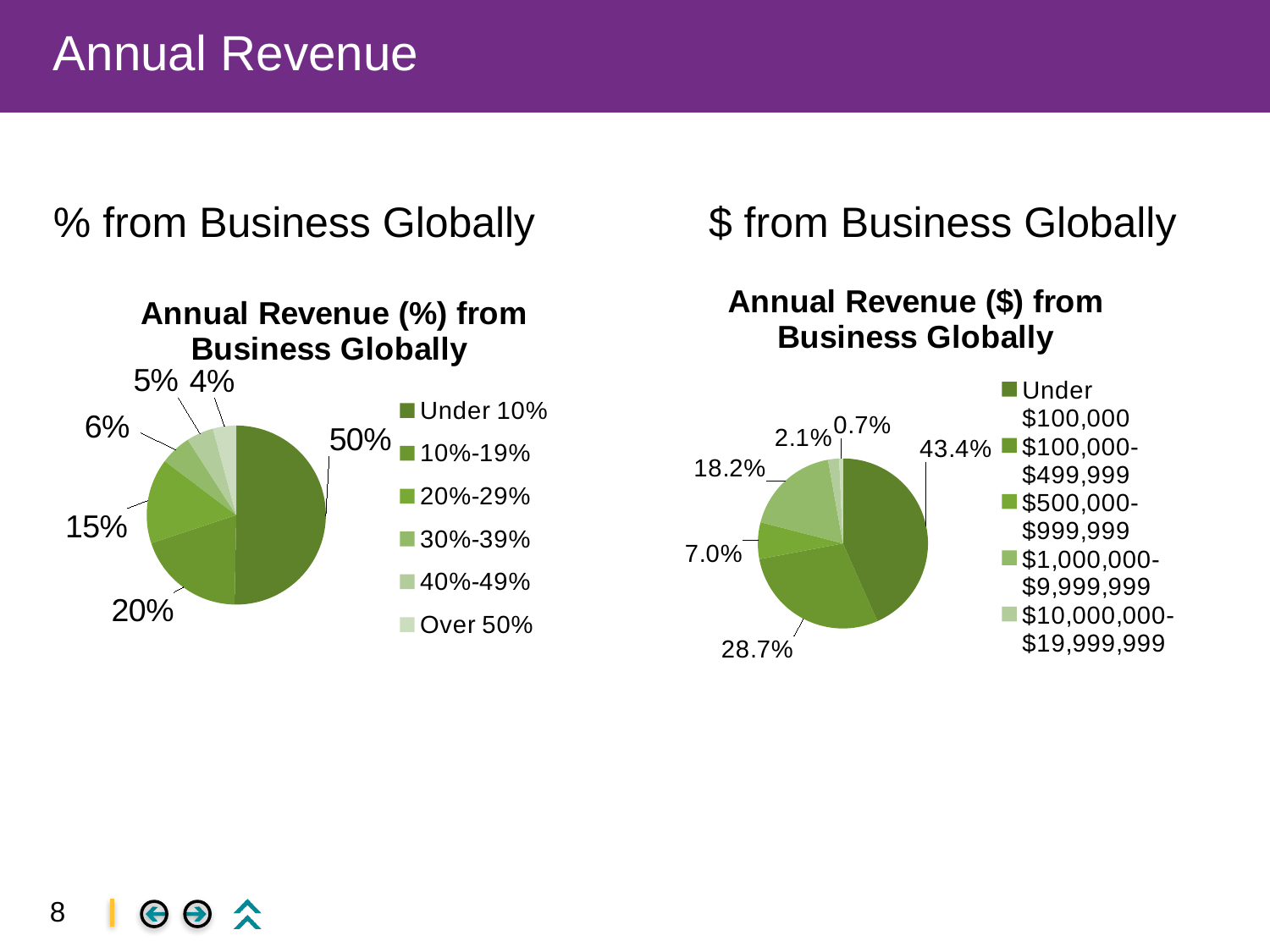
What type of chart is used for 'Annual Revenue ($) from Business Globally'? Pie chart In the 'Annual Revenue ($) from Business Globally' chart, what share of the pie is the 'Under $100,000' slice? 43.4% In the 'Annual Revenue ($) from Business Globally' chart, what share of the pie is the '$1,000,000-$9,999,999' slice? 18.2% In the 'Annual Revenue ($) from Business Globally' chart, which is larger: the '$100,000-$499,999' slice or the '$500,000-$999,999' slice? $100,000-$499,999 In the 'Annual Revenue (%) from Business Globally' chart, what share of the pie is the 'Under 10%' slice? 50% What is the title of the chart on the left side of the slide? Annual Revenue (%) from Business Globally In the 'Annual Revenue (%) from Business Globally' chart, what is the difference between the '20%-29%' slice and the '30%-39%' slice? 9% In the 'Annual Revenue (%) from Business Globally' chart, what share of the pie is the '10%-19%' slice? 20% In the 'Annual Revenue (%) from Business Globally' chart, which category has the largest slice? Under 10% In the 'Annual Revenue (%) from Business Globally' chart, which category has the smallest slice? Over 50% In the 'Annual Revenue (%) from Business Globally' chart, how many categories does the legend list? 6 In the 'Annual Revenue ($) from Business Globally' chart, what is the difference between the 'Under $100,000' slice and the '$100,000-$499,999' slice? 14.7%